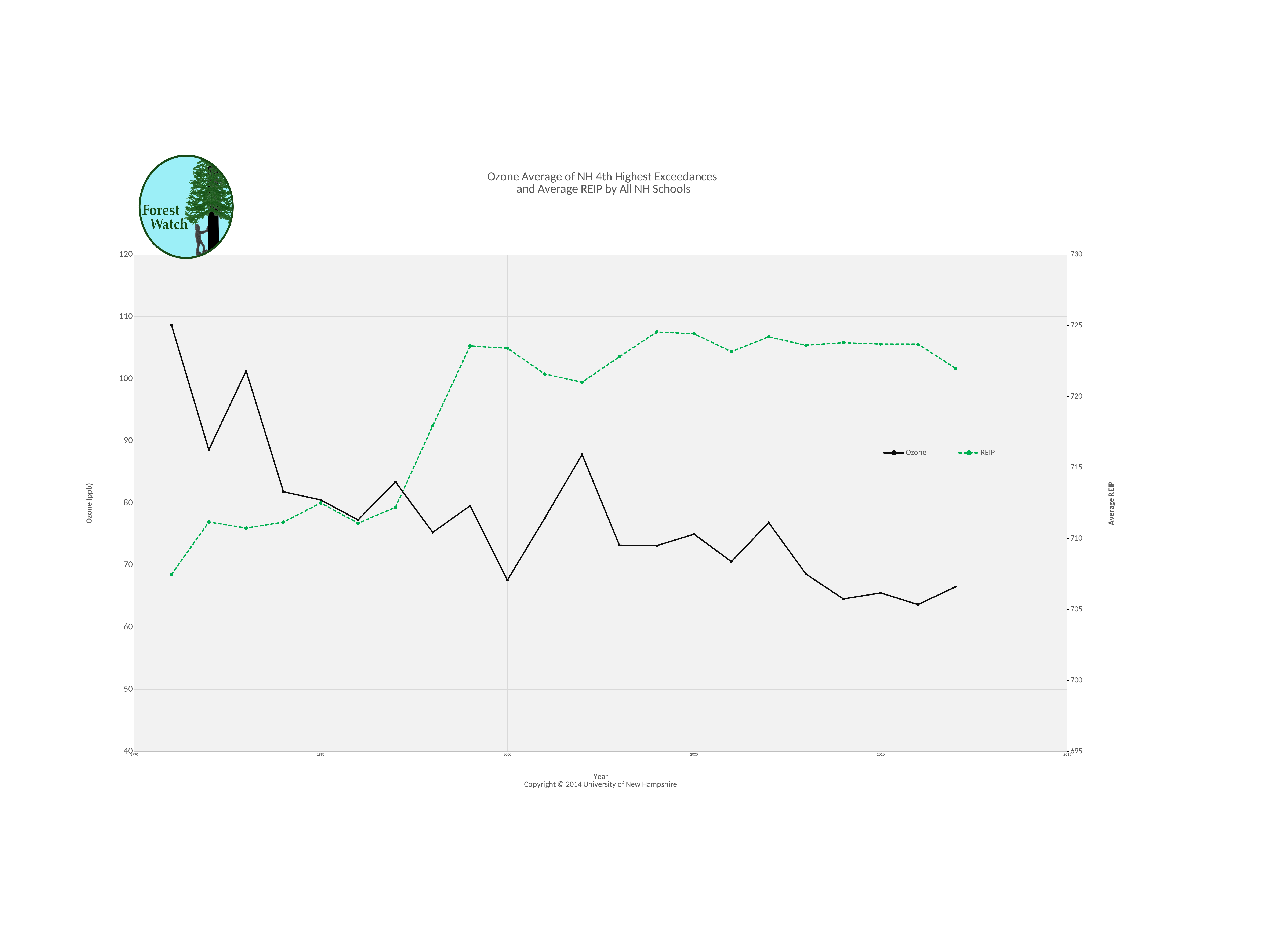
Overall, does the Ozone series rise or fall from 1991 to 2012? fall Which is larger, the Ozone value for 1991 or for 1993? 1991 In which year is the Ozone value highest? 1991 Is the Ozone value for 2000 greater or less than 70? less Is the Ozone value for 1991 greater or less than 100? greater How many series does the legend list? 2 In which year is the Ozone value lowest? 2011 Is the REIP value for 1999 greater or less than 720? greater What kind of chart is shown on the slide? Line chart In which year is the REIP value lowest? 1991 What is the title of the chart? Ozone Average of NH 4th Highest Exceedances and Average REIP by All NH Schools What are the two series named in the legend? Ozone and REIP